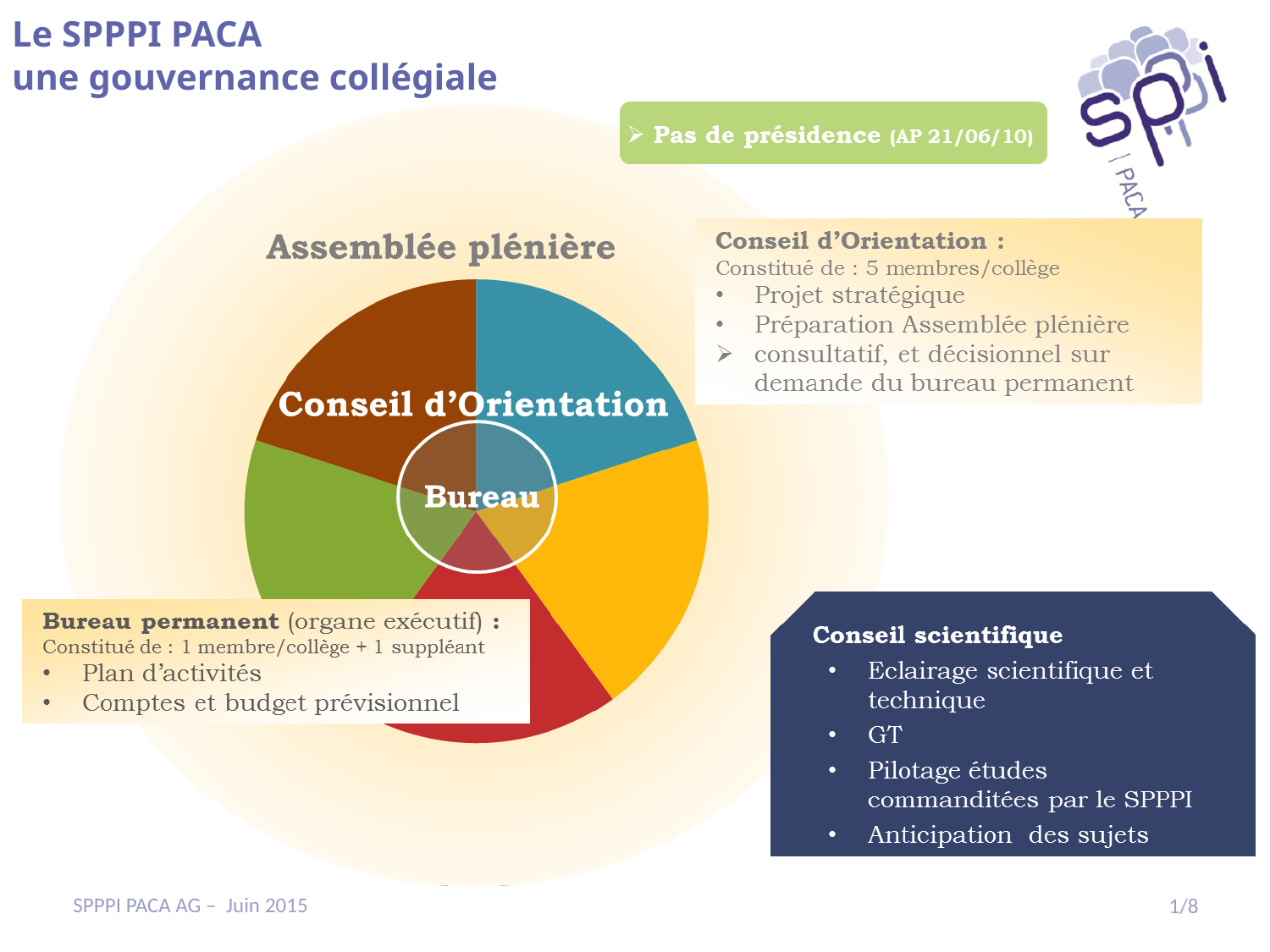
How many slices does the pie chart have? 5 What label appears in the small circle at the centre of the pie chart? Bureau Is the blue slice of the pie chart larger or smaller than the red slice? larger Which colour slice of the pie chart is the largest? yellow What label is written across the pie chart? Conseil d'Orientation What kind of chart is shown in the centre of the slide? pie chart Is the yellow slice of the pie chart larger or smaller than the red slice? larger